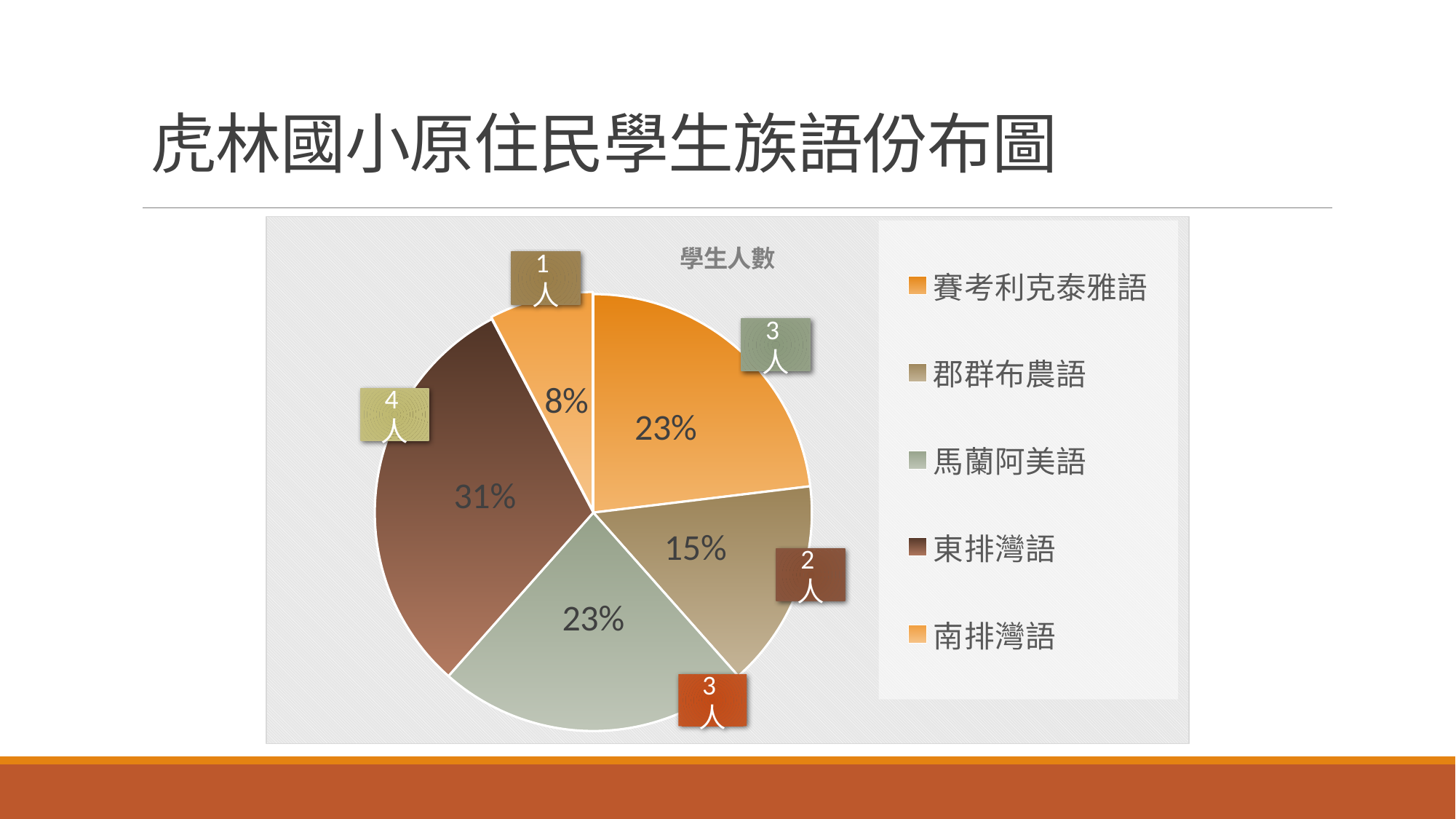
What share of the pie does 郡群布農語 have? 15% What share of the pie does 南排灣語 have? 8% How many languages does the legend list? 5 What share of the pie does 賽考利克泰雅語 have? 23% What is the difference in percentage points between the 東排灣語 slice and the 南排灣語 slice? 23 Which language has the smallest slice of the pie? 南排灣語 What is the title shown inside the chart area? 學生人數 Which language has the largest slice of the pie? 東排灣語 What kind of chart is shown on the slide? pie chart How many students are shown for 郡群布農語? 2人 How many students are shown for 東排灣語? 4人